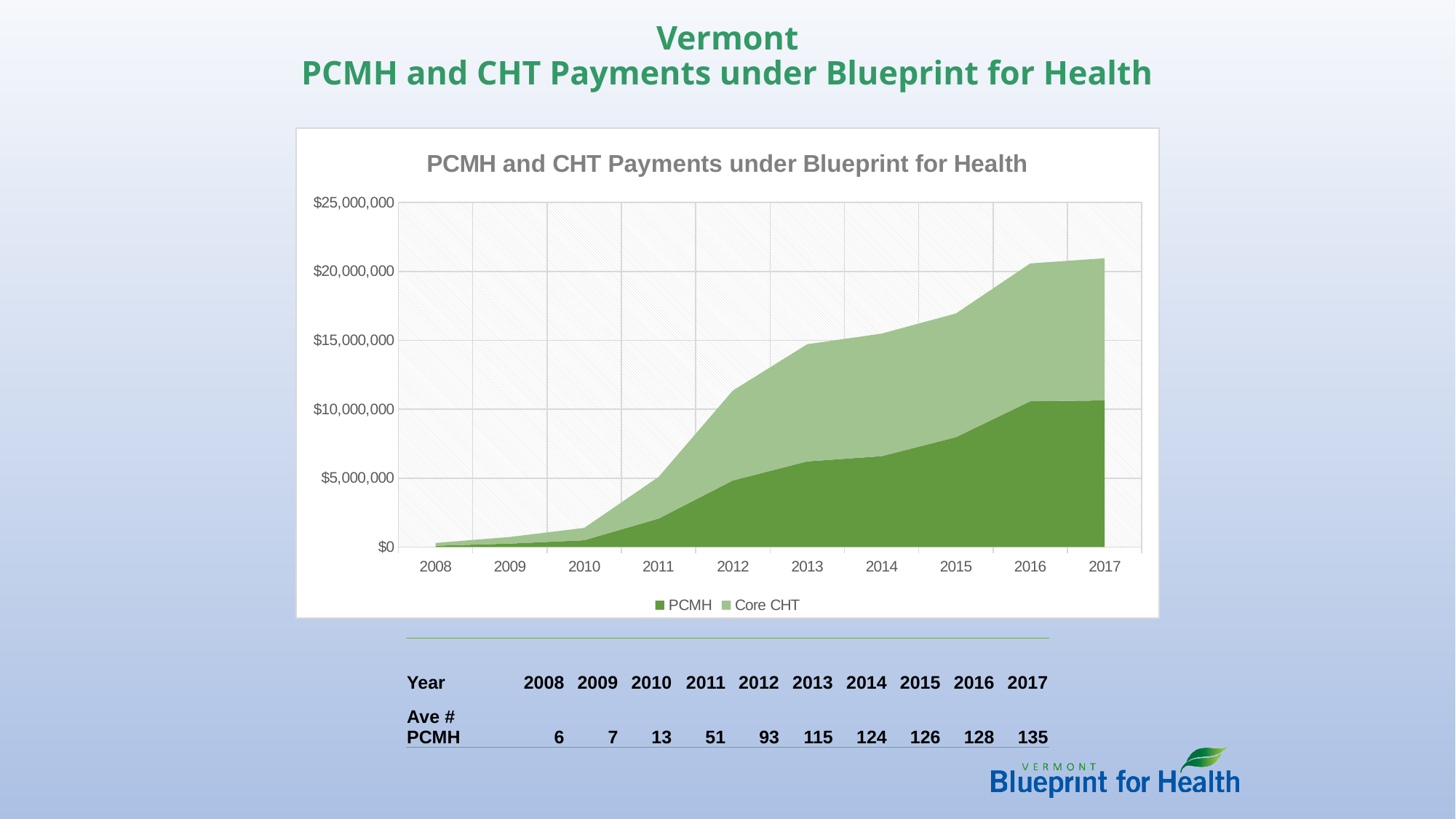
In which year are the total payments (PCMH plus Core CHT) lowest? 2008 How many series does the chart legend list? 2 What kind of chart is shown on the slide? Area chart Which is larger, the PCMH payment in 2016 or the PCMH payment in 2012? 2016 Is the total of PCMH and Core CHT payments in 2012 greater or less than $10,000,000? greater In which year are the total payments (PCMH plus Core CHT) highest? 2017 Is the PCMH payment value in 2011 greater or less than $5,000,000? less Is the total of PCMH and Core CHT payments in 2015 greater or less than $15,000,000? greater What is the title of the chart? PCMH and CHT Payments under Blueprint for Health How many years are shown along the x axis of the chart? 10 What are the two series named in the chart legend? PCMH and Core CHT Do the total payments generally rise or fall from 2008 to 2017? Rise